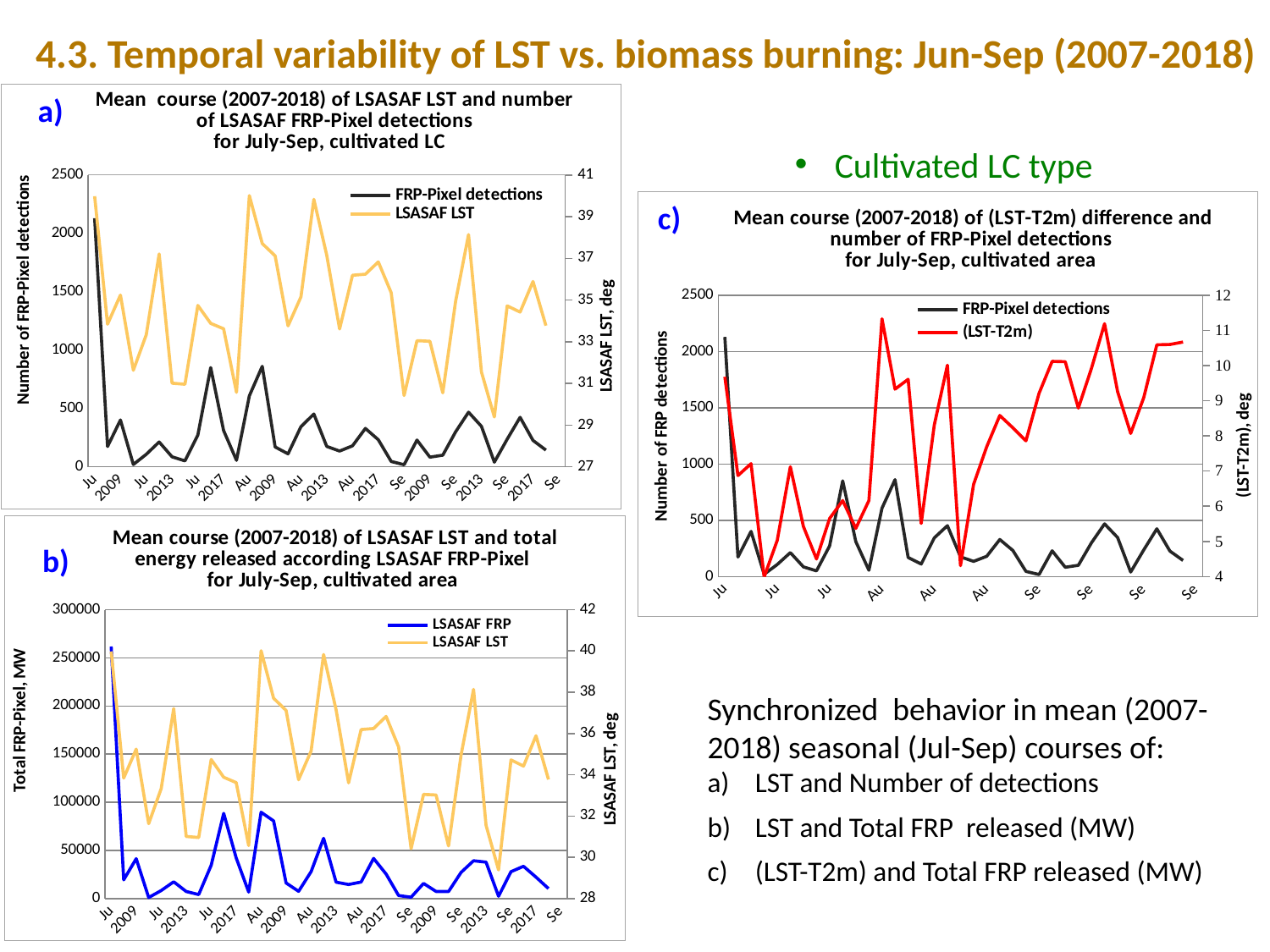
What kind of chart is chart a) (top left)? line chart What kind of chart is chart c) (right)? line chart In chart c) (right), is the highest value of the (LST-T2m) series greater or less than 10? greater In chart b) (bottom left), is the lowest value of the LSASAF LST series greater or less than 32? less What is the label of the right-hand vertical axis of chart a) (top left)? LSASAF LST, deg How many series does the legend of chart c) (right) list? 2 In chart b) (bottom left), is the first value of the LSASAF FRP series greater or less than 200000? greater Which series does the legend of chart b) (bottom left) list? LSASAF FRP, LSASAF LST How many series does the legend of chart a) (top left) list? 2 How many series does the legend of chart b) (bottom left) list? 2 In chart a) (top left), does the FRP-Pixel detections series rise or fall between its first and second points? fall